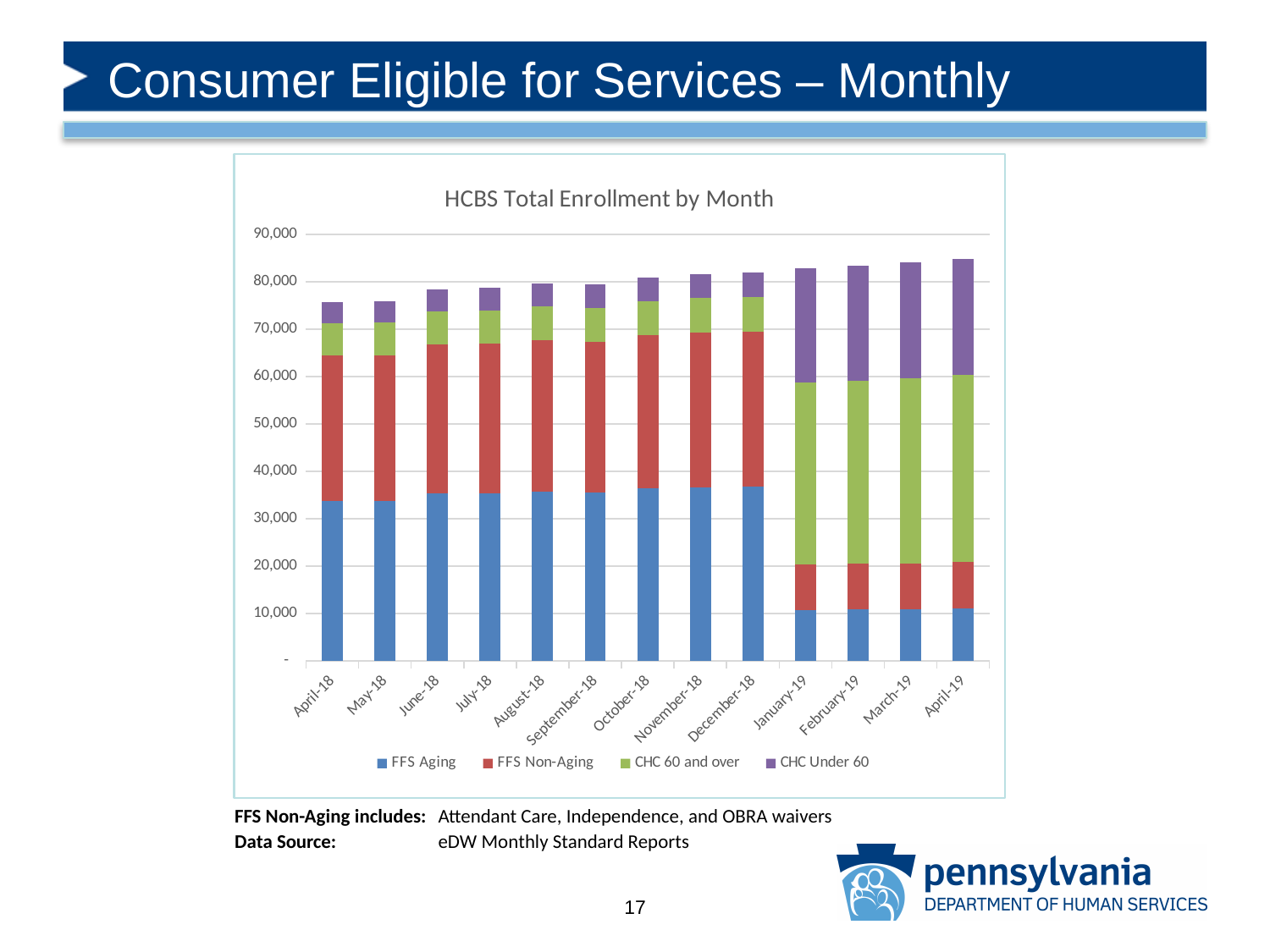
What is the title of the chart? HCBS Total Enrollment by Month Which month has the highest total enrollment? April-19 Which is larger, the CHC 60 and over value for April-18 or for April-19? April-19 How many months are shown along the x axis? 13 Is the total enrollment for April-18 greater or less than 80,000? less Is the FFS Aging value for April-18 greater or less than 30,000? greater Which series is shown in purple in the legend? CHC Under 60 Which is larger, the FFS Aging value for December-18 or for January-19? December-18 Do the total enrollment bars generally rise or fall from April-18 to April-19? rise Is the total enrollment for April-19 greater or less than 80,000? greater How many series does the legend list? 4 What kind of chart is shown on the slide? stacked bar chart